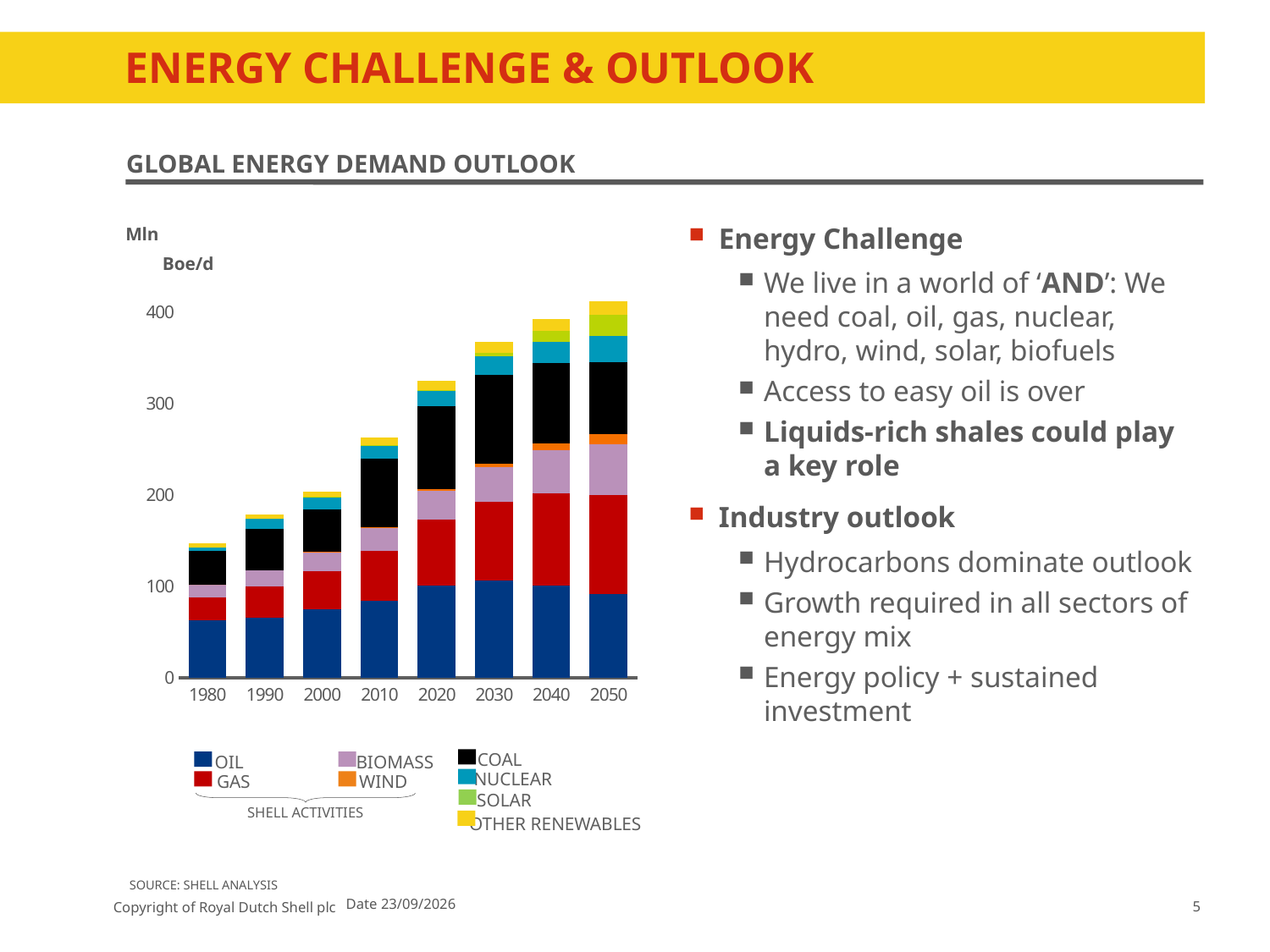
Which year has the highest total energy demand in the chart? 2050 Is the total value for 2020 greater or less than 300? greater Is the total value for 2010 greater or less than 300? less Do the total bar heights rise or fall from 1980 to 2050? Rise Is the total value for 2050 greater or less than 400? greater How many years (categories) are shown on the x axis of the chart? 8 How many series does the chart's legend list? 8 What is the title of the chart? GLOBAL ENERGY DEMAND OUTLOOK Which year has the larger total bar, 2030 or 1990? 2030 What kind of chart is shown on the slide? Stacked bar chart Which year has the lowest total energy demand in the chart? 1980